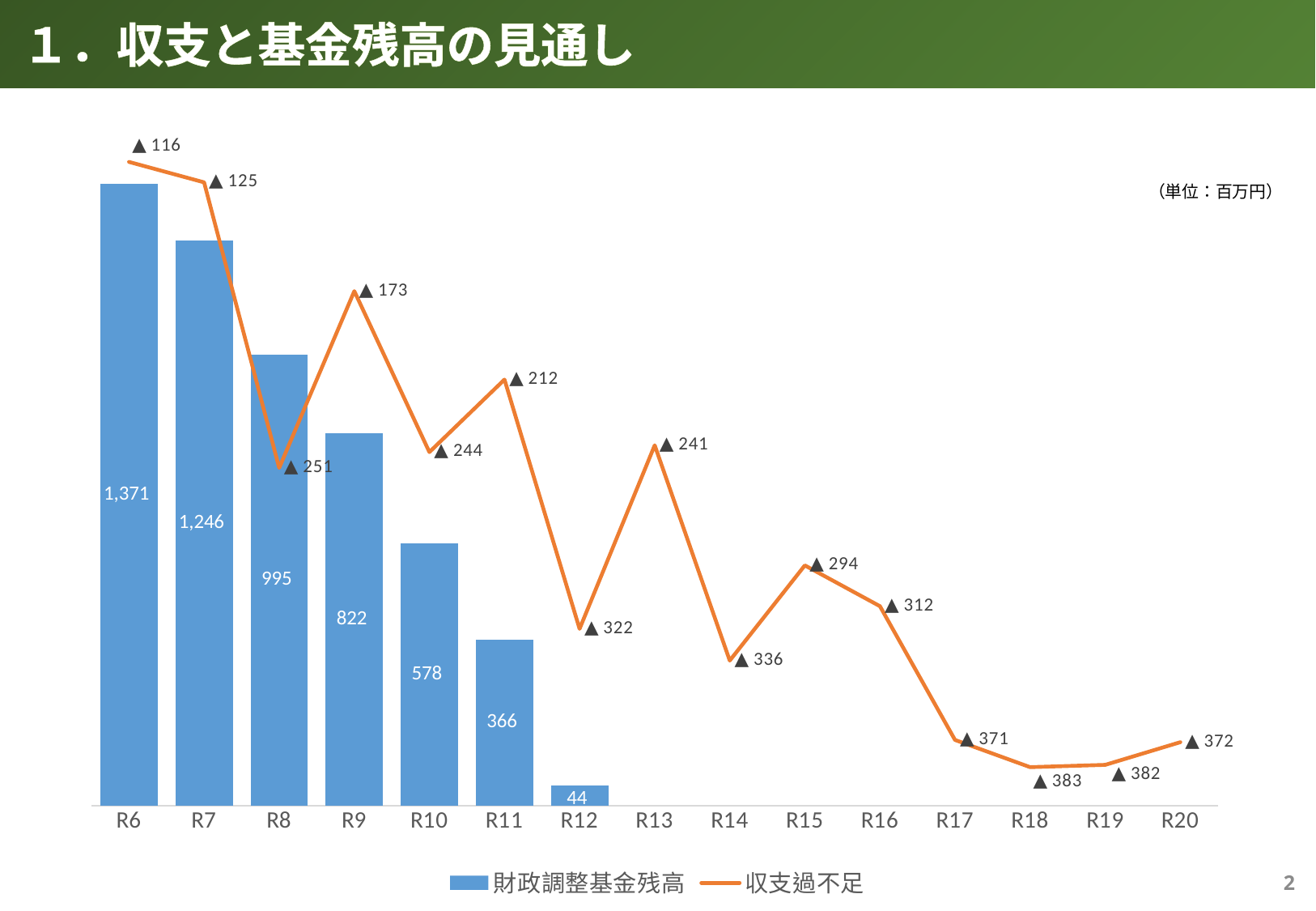
Which year has a larger 財政調整基金残高, R9 or R10? R9 What is the value of 財政調整基金残高 for R8? 995 What kind of chart is shown on the slide? Combination bar and line chart How many series does the legend list? 2 Which year has the highest 財政調整基金残高? R6 What unit is stated for the values in the chart? 百万円 Which year has the lowest 財政調整基金残高 among the bars shown? R12 What is the value of 収支過不足 for R14? ▲ 336 How many years have a 財政調整基金残高 bar plotted? 7 What is the difference between the 財政調整基金残高 for R6 and R7? 125 Do the 財政調整基金残高 bars rise or fall from R6 to R12? Fall What is the value of 収支過不足 for R20? ▲ 372